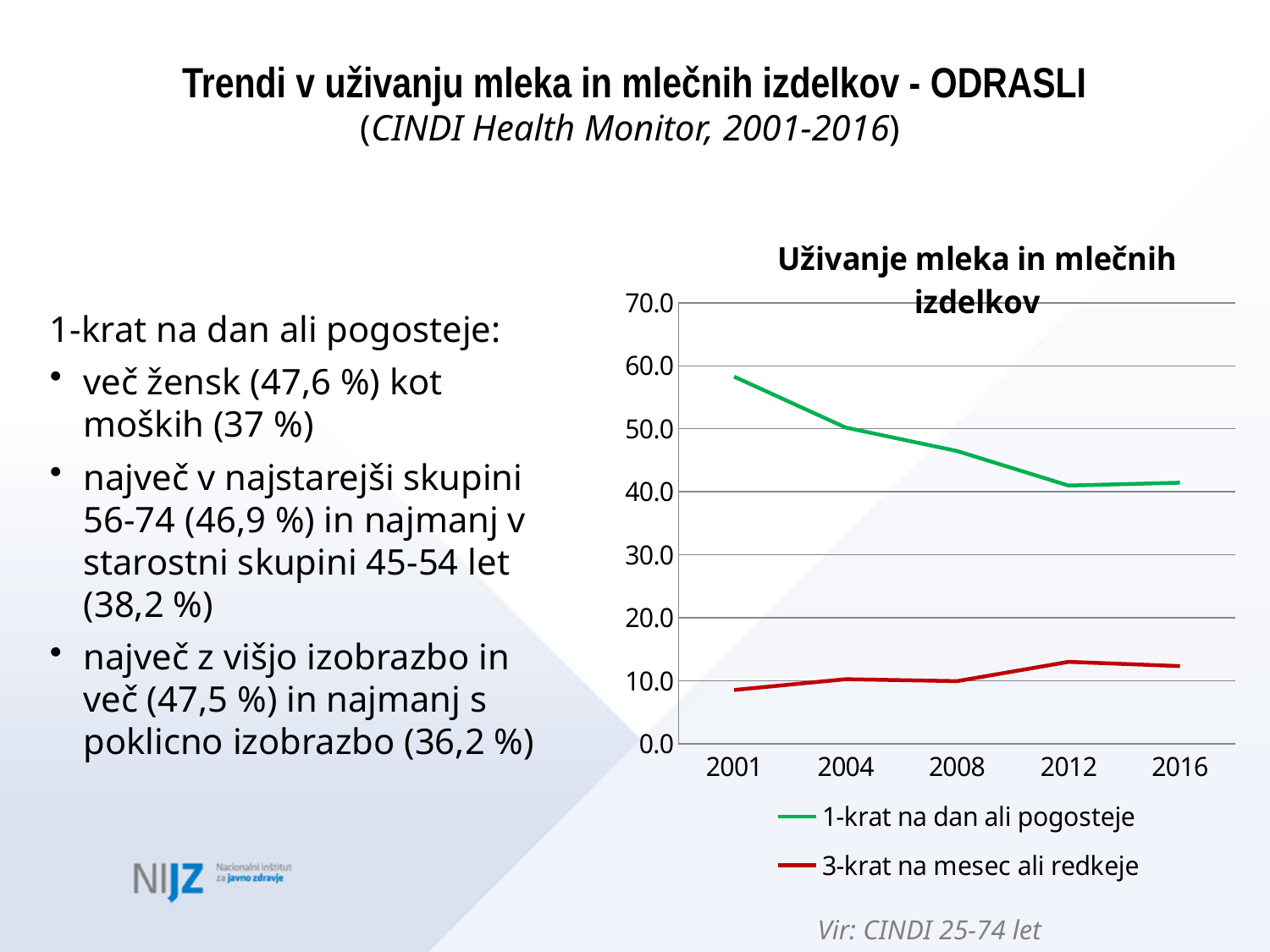
Which series is drawn in green? 1-krat na dan ali pogosteje What kind of chart is shown on the slide? line chart How many series does the chart legend list? 2 In which year is the value for '3-krat na mesec ali redkeje' lowest? 2001 In 2016, which series has the larger value: '1-krat na dan ali pogosteje' or '3-krat na mesec ali redkeje'? 1-krat na dan ali pogosteje How many years are shown on the x axis of the chart? 5 Is the value for '3-krat na mesec ali redkeje' in 2016 greater or less than 20.0? less What is the title of the chart? Uživanje mleka in mlečnih izdelkov Is the value for '1-krat na dan ali pogosteje' in 2001 greater or less than 50.0? greater Does the value for '3-krat na mesec ali redkeje' rise or fall from 2001 to 2012? rise In which year is the value for '1-krat na dan ali pogosteje' highest? 2001 Does the value for '1-krat na dan ali pogosteje' rise or fall from 2001 to 2012? fall